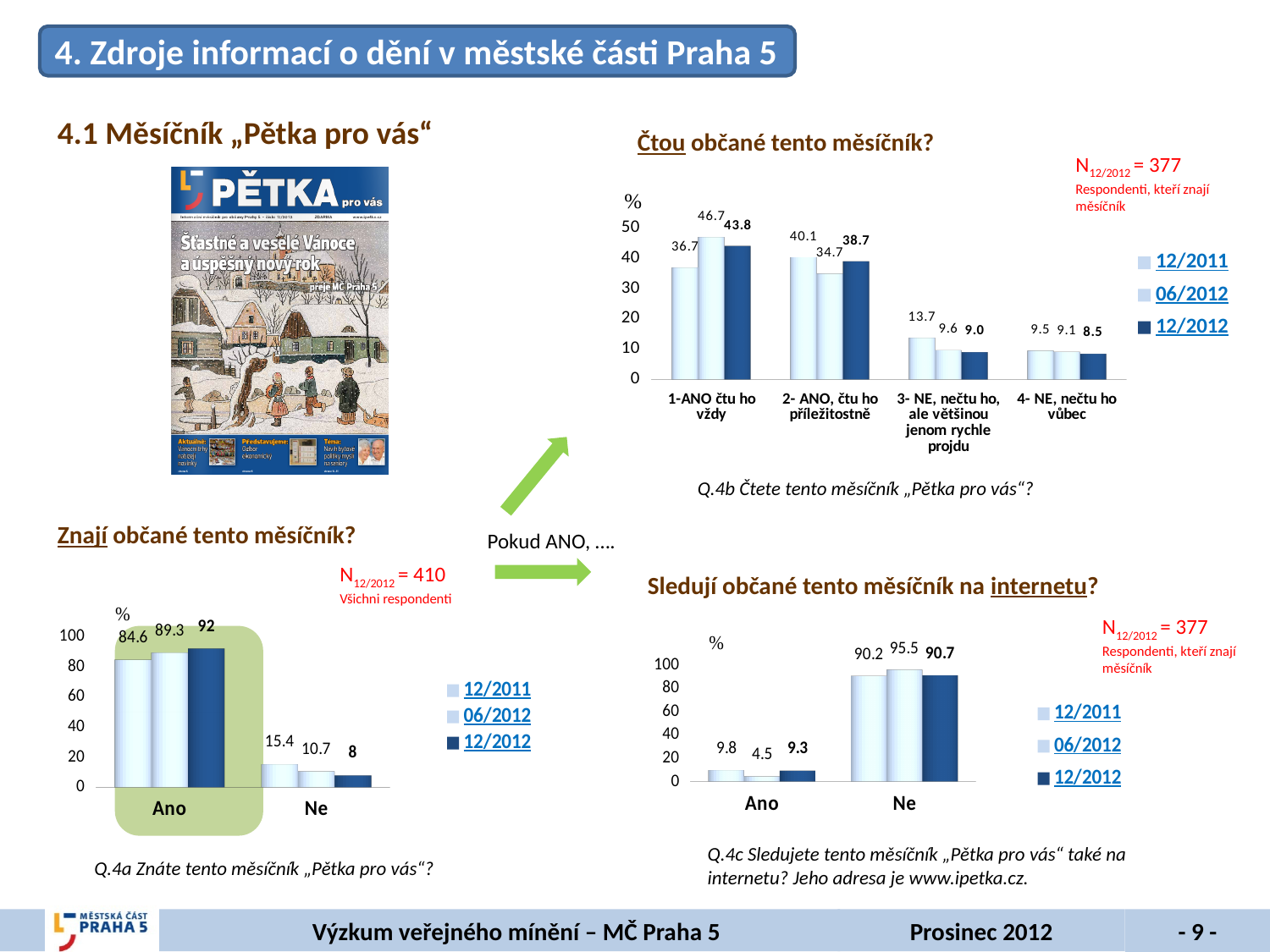
In the chart "Čtou občané tento měsíčník?", what is the 12/2011 value for "2- ANO, čtu ho příležitostně"? 40.1 In the chart "Znají občané tento měsíčník?", do the "Ano" values rise or fall from 12/2011 to 12/2012? rise In the chart "Čtou občané tento měsíčník?", how many categories are shown on the x axis? 4 What kind of chart is "Sledují občané tento měsíčník na internetu?"? bar chart In the chart "Čtou občané tento měsíčník?", what is the difference between the 06/2012 and 12/2011 values for "1-ANO čtu ho vždy"? 10 In the chart "Čtou občané tento měsíčník?", which category has the lowest 12/2012 value? 4- NE, nečtu ho vůbec In the chart "Sledují občané tento měsíčník na internetu?", what is the 06/2012 value for "Ne"? 95.5 In the chart "Čtou občané tento měsíčník?", what is the 12/2012 value for "1-ANO čtu ho vždy"? 43.8 In the chart "Znají občané tento měsíčník?", what is the 12/2012 value for "Ano"? 92 In the chart "Znají občané tento měsíčník?", what is the 12/2011 value for "Ne"? 15.4 In the chart "Sledují občané tento měsíčník na internetu?", which is larger for 12/2012: "Ano" or "Ne"? Ne In the chart "Znají občané tento měsíčník?", how many series does the legend list? 3